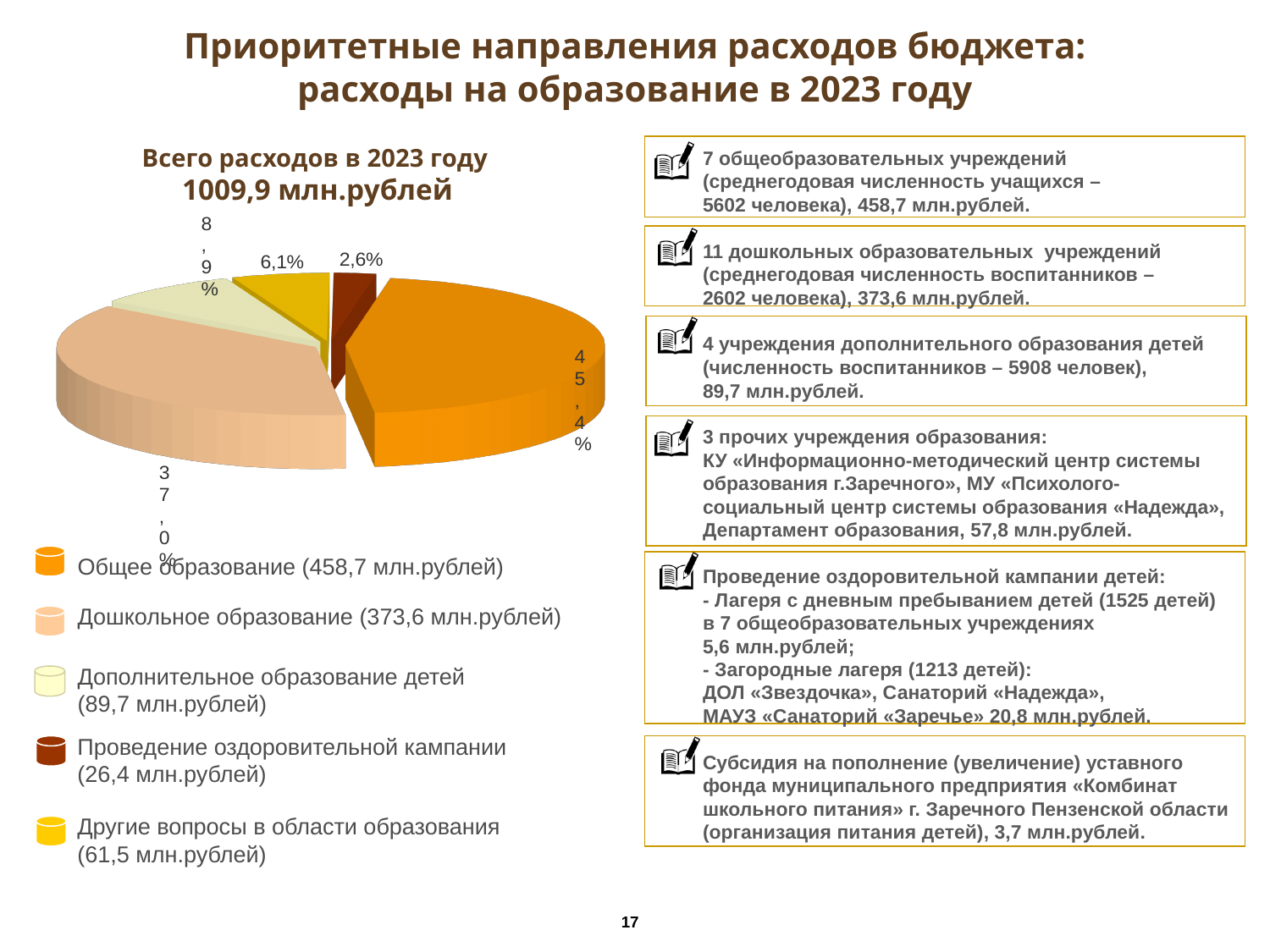
What is the difference in percentage points between the Общее образование slice and the Дошкольное образование slice? 8,4 How many slices does the pie chart have? 5 What total expenditure for 2023 is stated in the chart title? 1009,9 млн.рублей What percentage share does the slice for Дополнительное образование детей have? 8,9% What percentage share does the slice for Проведение оздоровительной кампании have? 2,6% Which category has the smallest slice of the pie? Проведение оздоровительной кампании According to the legend, how many million rubles are spent on Другие вопросы в области образования? 61,5 млн.рублей Which is larger: the slice for Дополнительное образование детей or the slice for Другие вопросы в области образования? Дополнительное образование детей What percentage share does the slice for Дошкольное образование have? 37,0% What kind of chart is shown on the slide? pie chart Which category has the largest slice of the pie? Общее образование